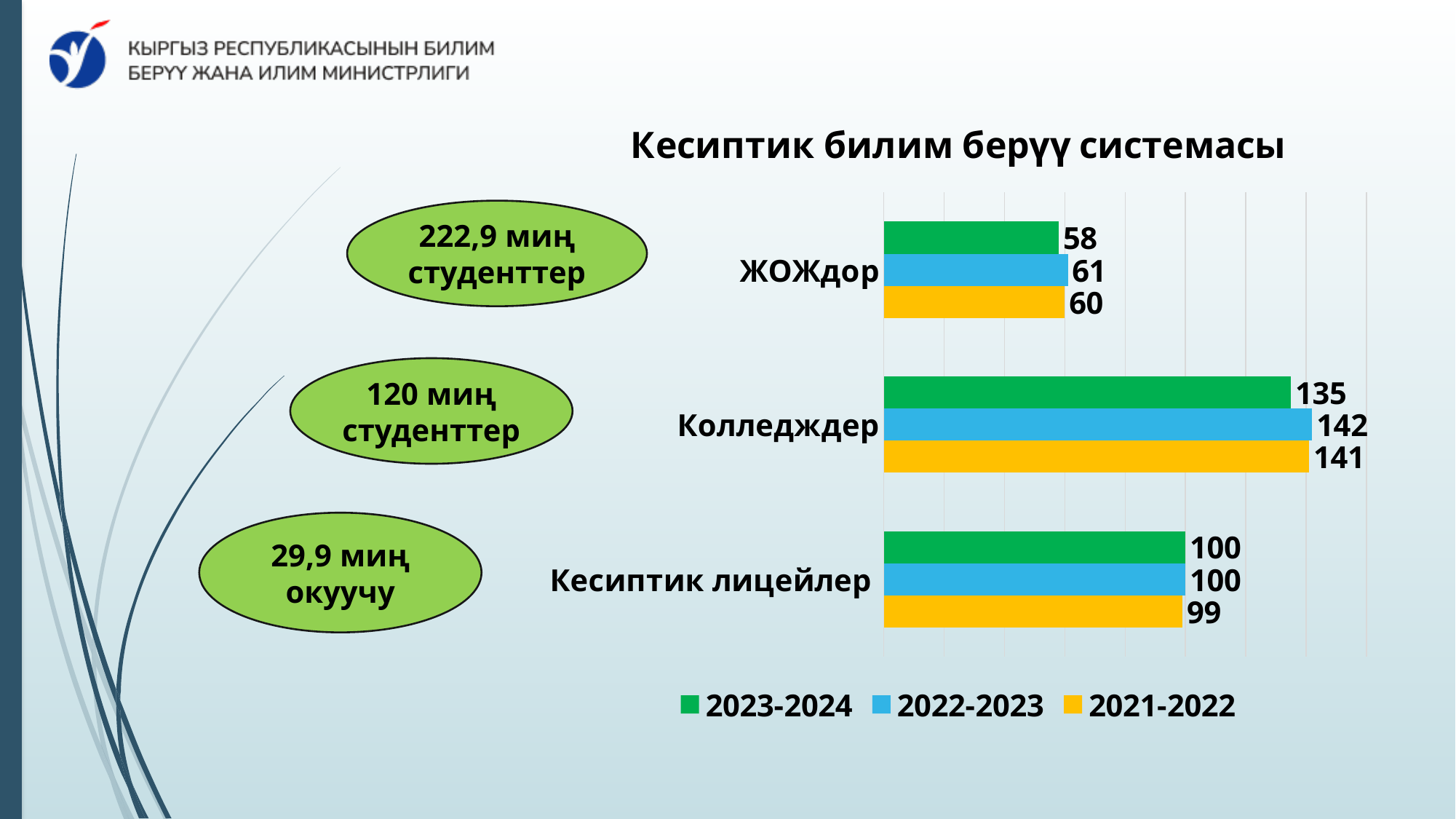
Which category has the highest value in the 2023-2024 series? Колледждер What is the title of the chart? Кесиптик билим берүү системасы What is the value for Кесиптик лицейлер in the 2021-2022 series? 99 What is the value for ЖОЖдор in the 2023-2024 series? 58 What kind of chart is shown on the slide? bar chart Which category has the lowest value in the 2021-2022 series? ЖОЖдор How many categories are shown on the chart? 3 How many series does the legend list? 3 What is the value for Колледждер in the 2022-2023 series? 142 What is the difference between the 2022-2023 and 2023-2024 values for Колледждер? 7 Which is larger for ЖОЖдор: the 2022-2023 value or the 2023-2024 value? 2022-2023 Which colour represents the 2021-2022 series in the legend? yellow